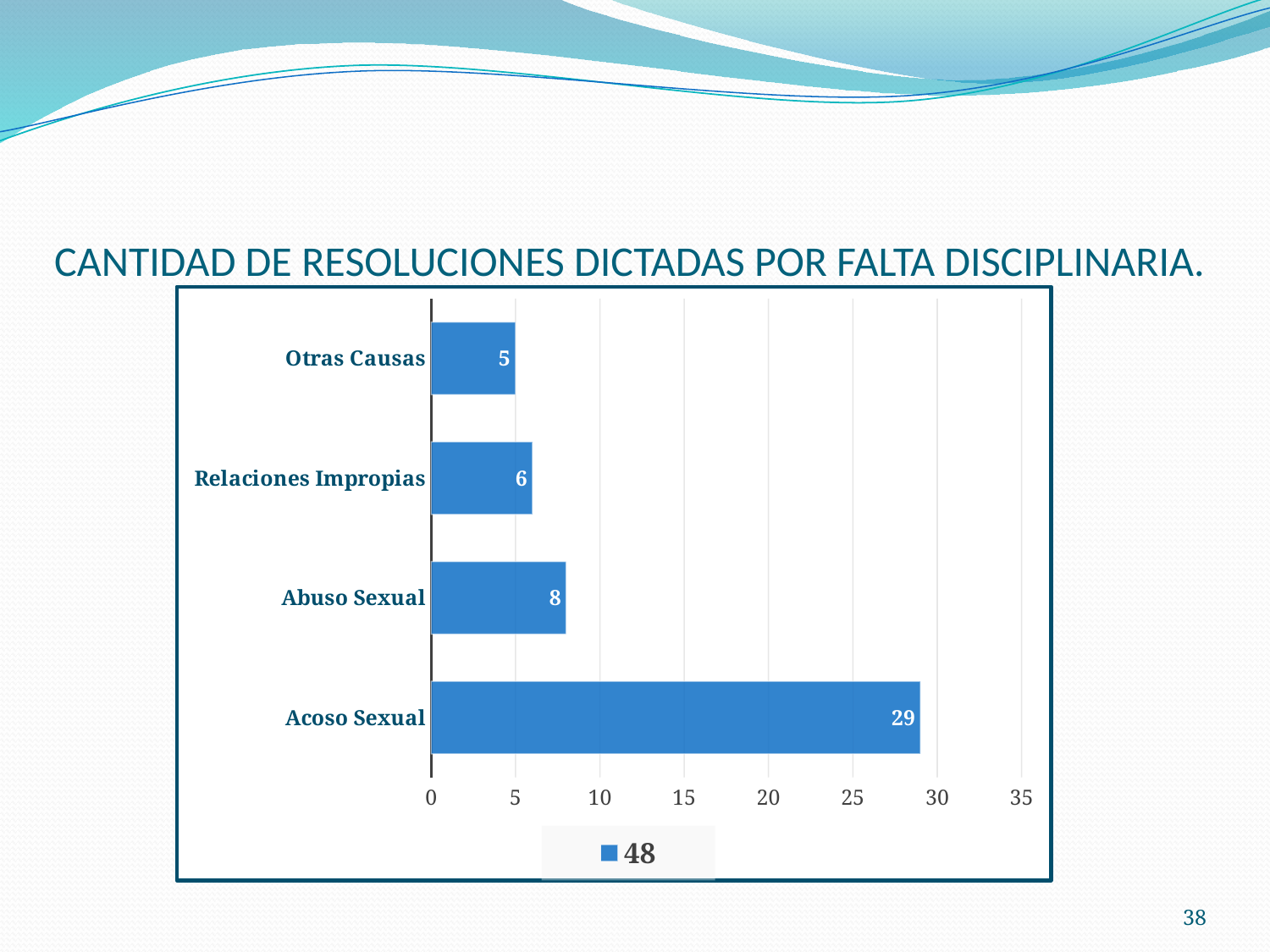
Which category has the lowest value? Otras Causas How many categories are shown in the chart? 4 What is the title of the chart? CANTIDAD DE RESOLUCIONES DICTADAS POR FALTA DISCIPLINARIA. Is the value for Acoso Sexual greater or less than 25? greater What is the value for Abuso Sexual? 8 What is the difference between the values for Acoso Sexual and Abuso Sexual? 21 What is the value for Relaciones Impropias? 6 What kind of chart is shown on the slide? bar chart What is the value for Otras Causas? 5 Which is larger, the value for Relaciones Impropias or the value for Otras Causas? Relaciones Impropias Which category has the highest value? Acoso Sexual What is the value for Acoso Sexual? 29